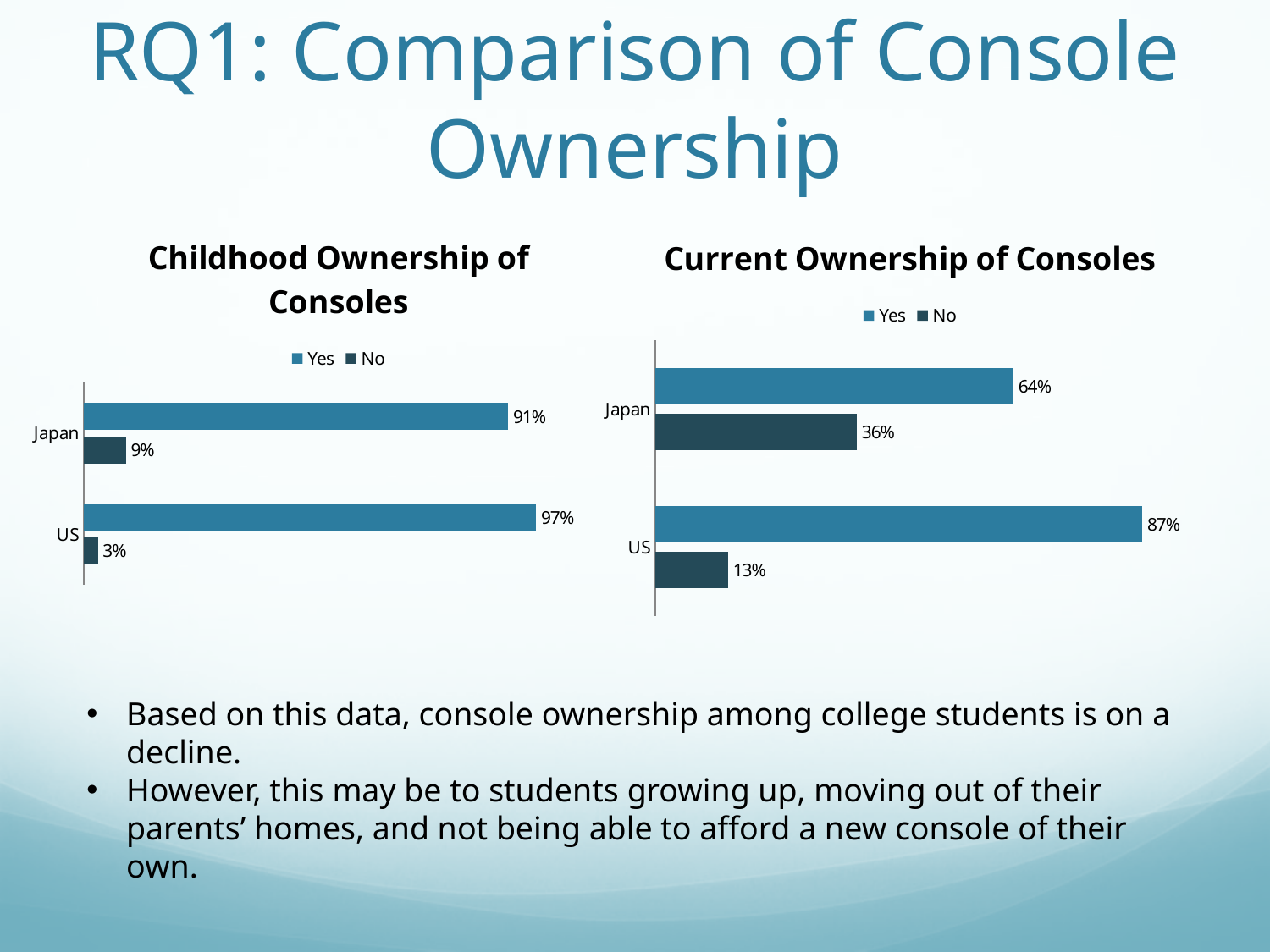
In the 'Childhood Ownership of Consoles' chart, what is the difference between the 'No' values for Japan and US? 6% In the 'Childhood Ownership of Consoles' chart, which category has the lowest 'No' value? US In the 'Current Ownership of Consoles' chart, what is the 'No' value for US? 13% In the 'Childhood Ownership of Consoles' chart, what is the 'Yes' value for Japan? 91% In the 'Current Ownership of Consoles' chart, what is the difference between the 'Yes' values for US and Japan? 23% What kind of chart is the 'Childhood Ownership of Consoles' chart? Bar chart In the 'Current Ownership of Consoles' chart, is the 'No' value larger for Japan or for US? Japan In the 'Current Ownership of Consoles' chart, what is the 'Yes' value for Japan? 64% How many categories are shown in the 'Childhood Ownership of Consoles' chart? 2 In the 'Current Ownership of Consoles' chart, which category has the higher 'Yes' value? US In the 'Childhood Ownership of Consoles' chart, what is the 'No' value for US? 3% How many series does the legend of the 'Current Ownership of Consoles' chart list? 2